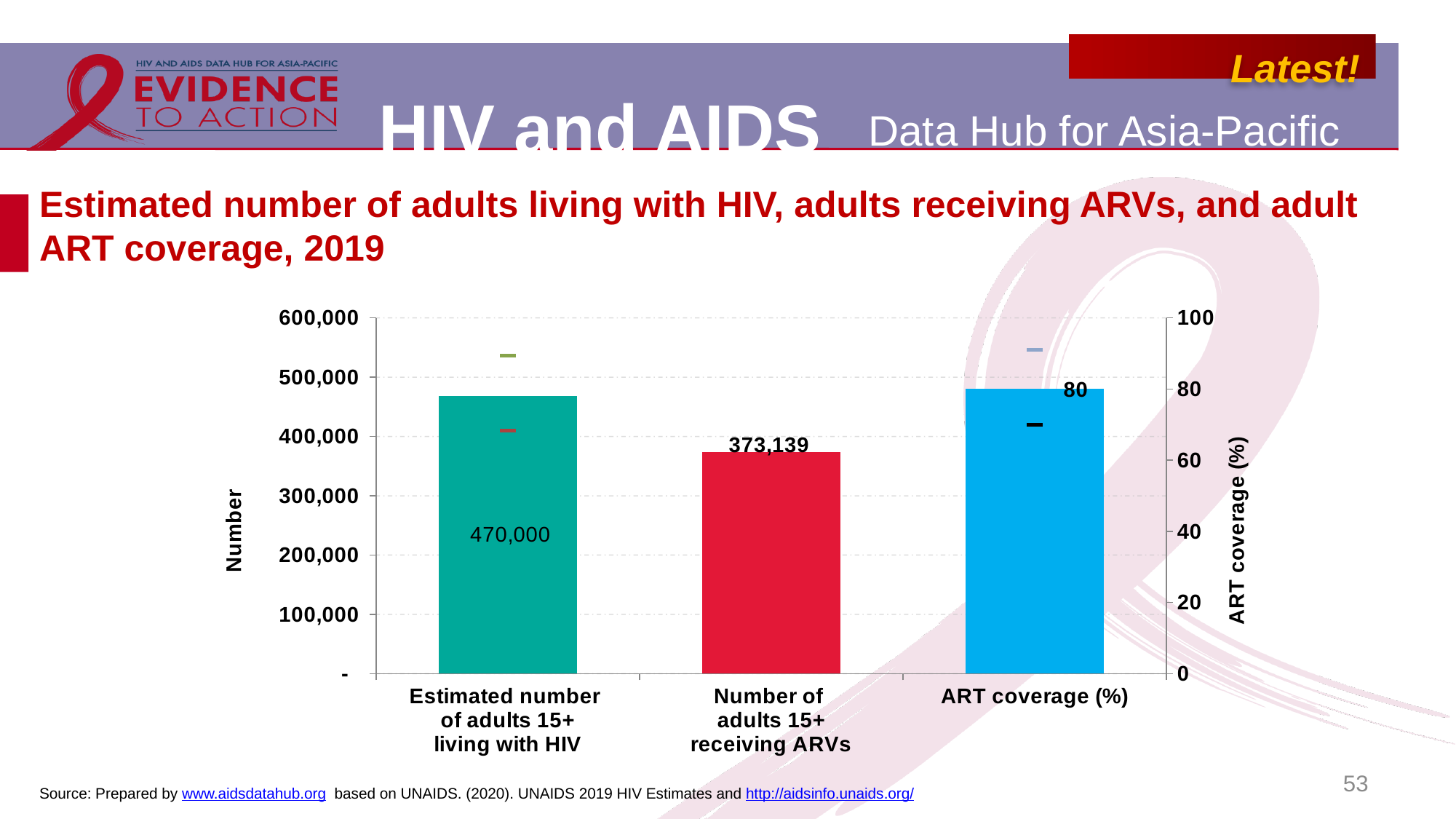
What is the ART coverage (%) value shown on the chart? 80 What is the estimated number of adults 15+ living with HIV shown on the chart? 470,000 How many bars are plotted on the chart? 3 Is the number of adults 15+ receiving ARVs greater or less than 400,000? less What is the difference between the estimated number of adults 15+ living with HIV and the number of adults 15+ receiving ARVs? 96,861 What kind of chart is shown on the slide? Bar chart Which is larger: the estimated number of adults 15+ living with HIV or the number of adults 15+ receiving ARVs? Estimated number of adults 15+ living with HIV What is the number of adults 15+ receiving ARVs shown on the chart? 373,139 What is the maximum value shown on the right vertical axis of the chart? 100 Is the estimated number of adults 15+ living with HIV greater or less than 400,000? greater What is the label of the left vertical axis of the chart? Number What is the label of the right vertical axis of the chart? ART coverage (%)